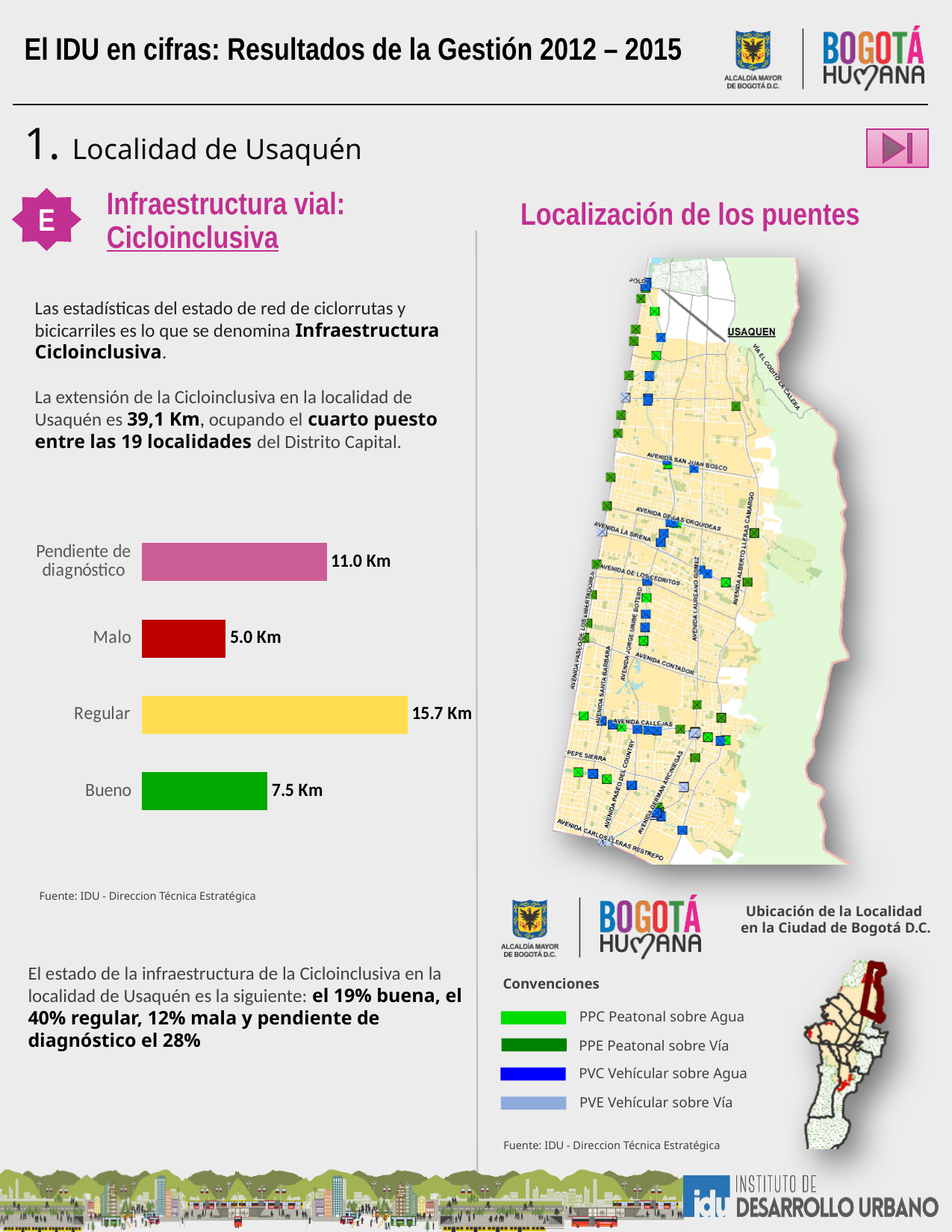
What is the value for Malo in the bar chart? 5.0 Km What is the value for Pendiente de diagnóstico in the bar chart? 11.0 Km Which is larger in the bar chart, Bueno or Malo? Bueno What is the difference between the values for Pendiente de diagnóstico and Malo in the bar chart? 6.0 Km What is the value for Bueno in the bar chart? 7.5 Km What is the difference between the values for Regular and Bueno in the bar chart? 8.2 Km How many categories are shown in the bar chart? 4 What colour is the bar for Regular in the bar chart? Yellow Which category has the lowest value in the bar chart? Malo Which category has the highest value in the bar chart? Regular What is the value for Regular in the bar chart? 15.7 Km What kind of chart is shown on the left side of the slide? Bar chart